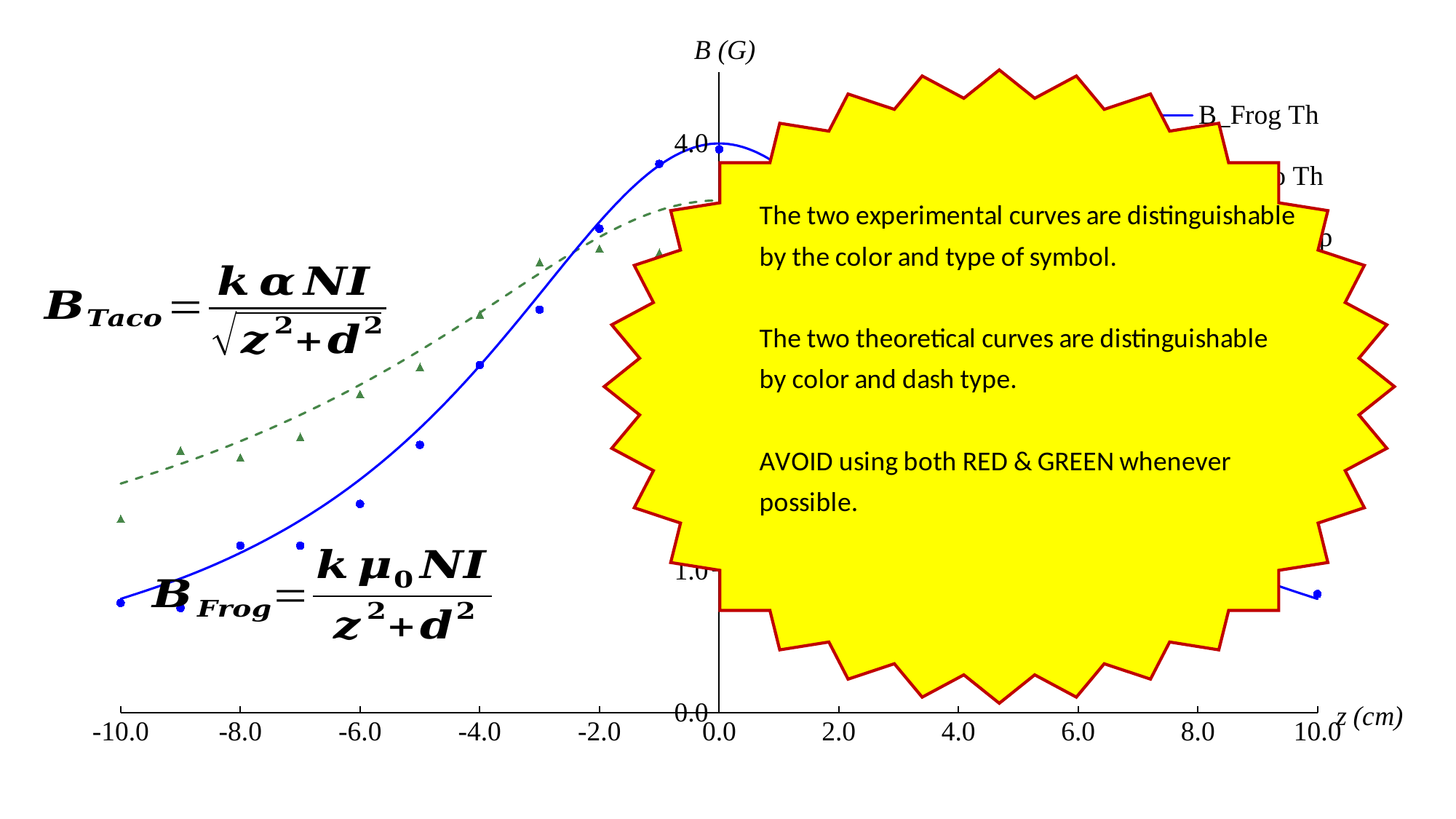
How many labeled tick marks are on the horizontal (z) axis? 11 What is the label of the vertical axis of the chart? B (G) What is the label of the horizontal axis of the chart? z (cm) Do the blue circle data points rise or fall as z goes from -10.0 to 0.0? rise What is the highest labeled tick value on the vertical axis? 4.0 Is the value of the blue circle data point at z = -10.0 greater or less than 1.0? less At z = -8.0, which data point is higher: the blue circle or the green triangle? the green triangle Is the value of the green triangle data point at z = -10.0 greater or less than 1.0? greater At z = -6.0, which data point is higher: the blue circle or the green triangle? the green triangle Is the value of the blue circle data point at z = 10.0 greater or less than 1.0? less